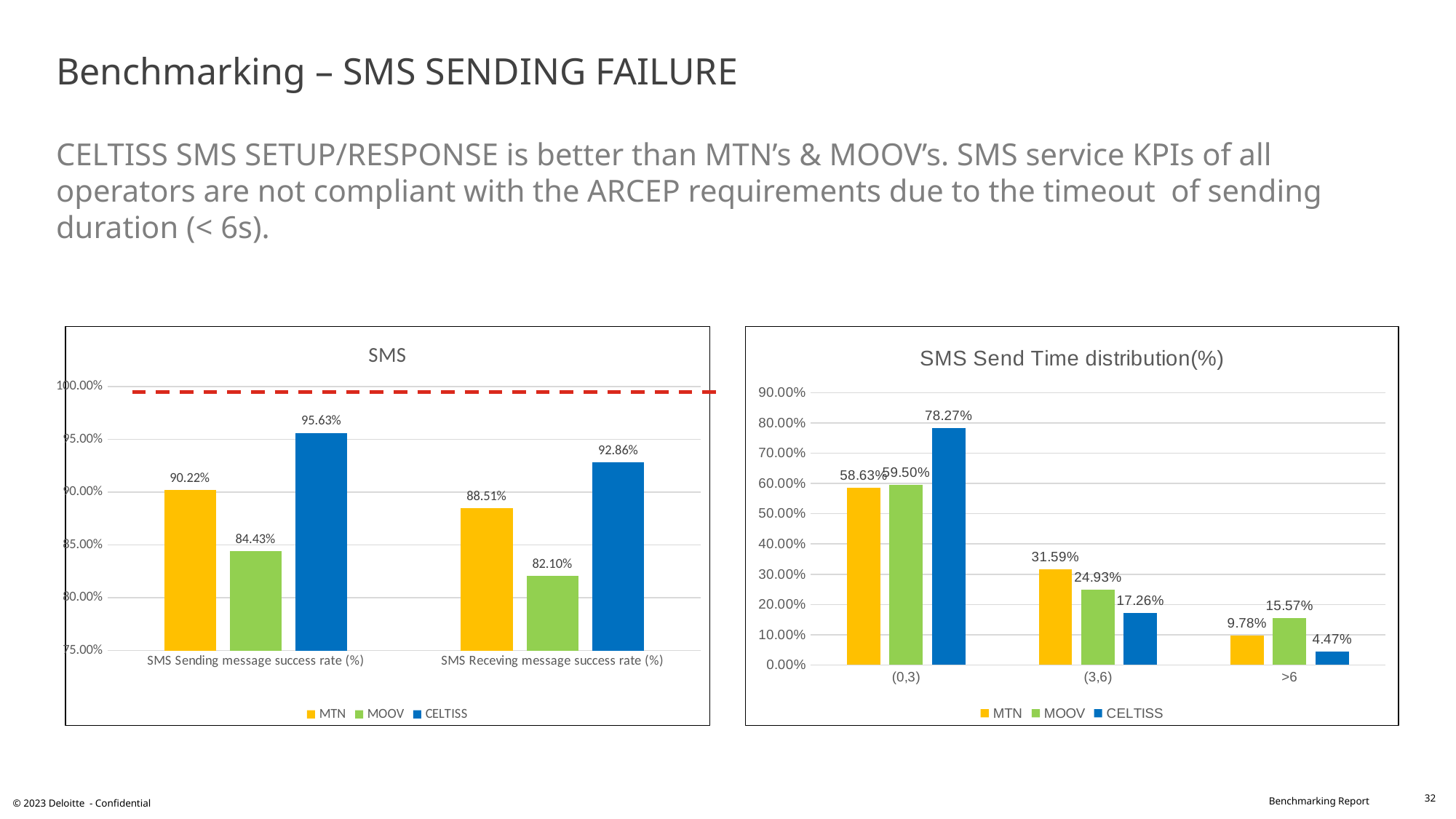
In the 'SMS' chart, what is the SMS Sending message success rate (%) for CELTISS? 95.63% In the 'SMS' chart, which operator has the lowest SMS Sending message success rate (%)? MOOV In the 'SMS Send Time distribution(%)' chart, how many categories are shown on the x axis? 3 In the 'SMS' chart, what is the difference between CELTISS's and MTN's SMS Receving message success rate (%)? 4.35% What kind of chart is the 'SMS Send Time distribution(%)' chart? Bar chart In the 'SMS Send Time distribution(%)' chart, is the value for MOOV in the >6 category larger or smaller than the value for CELTISS in the >6 category? larger In the 'SMS Send Time distribution(%)' chart, what is the difference between MTN's and MOOV's values in the (3,6) category? 6.66% In the 'SMS' chart, how many series does the legend list? 3 In the 'SMS Send Time distribution(%)' chart, what is the value for MTN in the >6 category? 9.78% In the 'SMS Send Time distribution(%)' chart, which operator has the highest value in the (3,6) category? MTN In the 'SMS' chart, what is the SMS Receving message success rate (%) for MOOV? 82.10% In the 'SMS Send Time distribution(%)' chart, what is the value for CELTISS in the (0,3) category? 78.27%